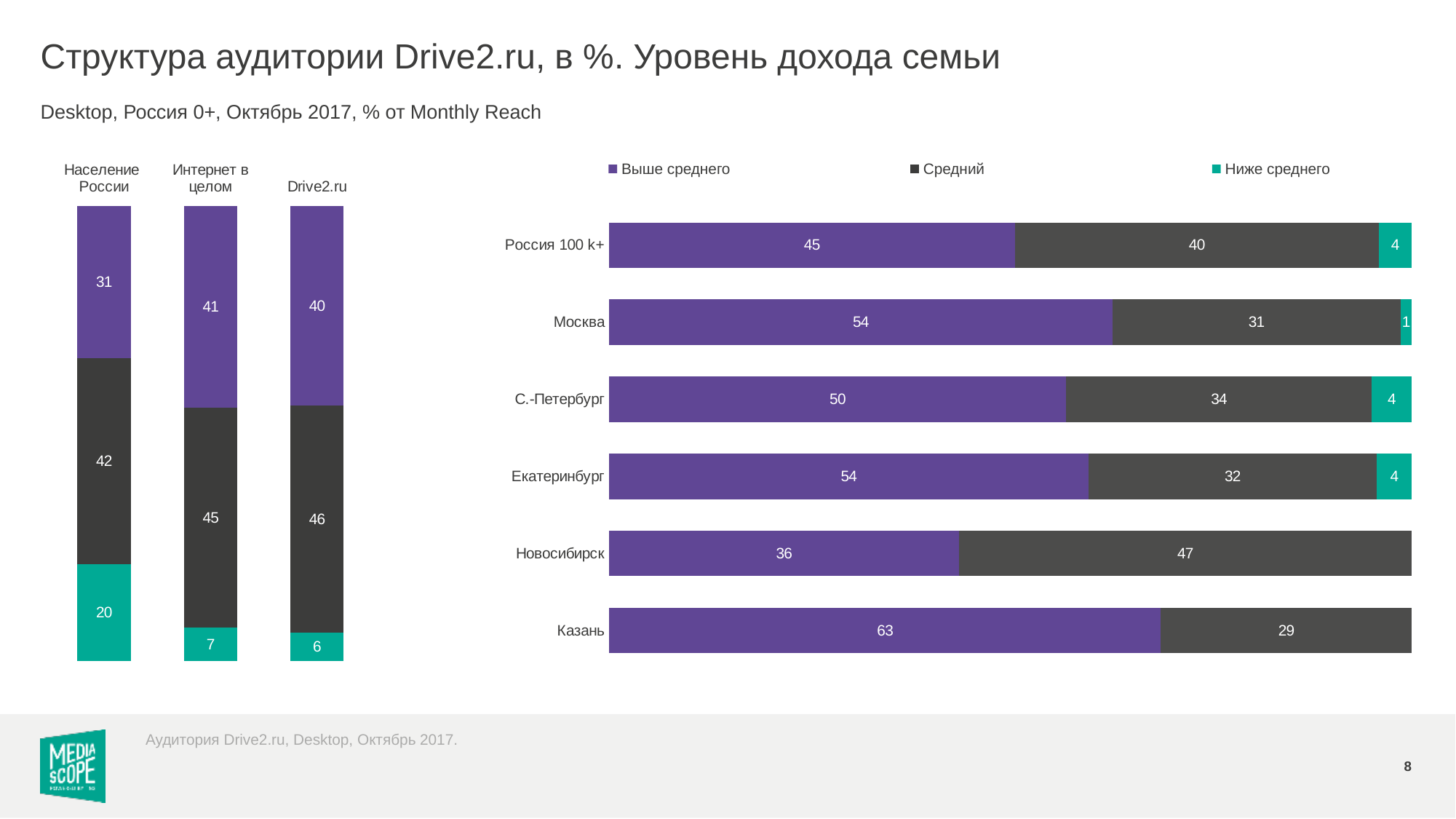
How many categories are shown in the right chart? 6 In the right chart, what is the difference between the 'Выше среднего' and 'Средний' values for Москва? 23 How many series does the legend list? 3 What type of chart is the left chart? Stacked bar chart In the right chart, what is the value of 'Ниже среднего' for Москва? 1 In the right chart, which category has the highest 'Выше среднего' value? Казань In the right chart, what is the value of 'Выше среднего' for Казань? 63 In the right chart, what is the value of 'Средний' for Новосибирск? 47 In the left chart, which has the larger 'Ниже среднего' value: Население России or Drive2.ru? Население России In the right chart, which category has the lowest 'Выше среднего' value? Новосибирск In the left chart, what is the value of 'Средний' for Drive2.ru? 46 In the left chart, what is the difference between the 'Выше среднего' values for Интернет в целом and Население России? 10